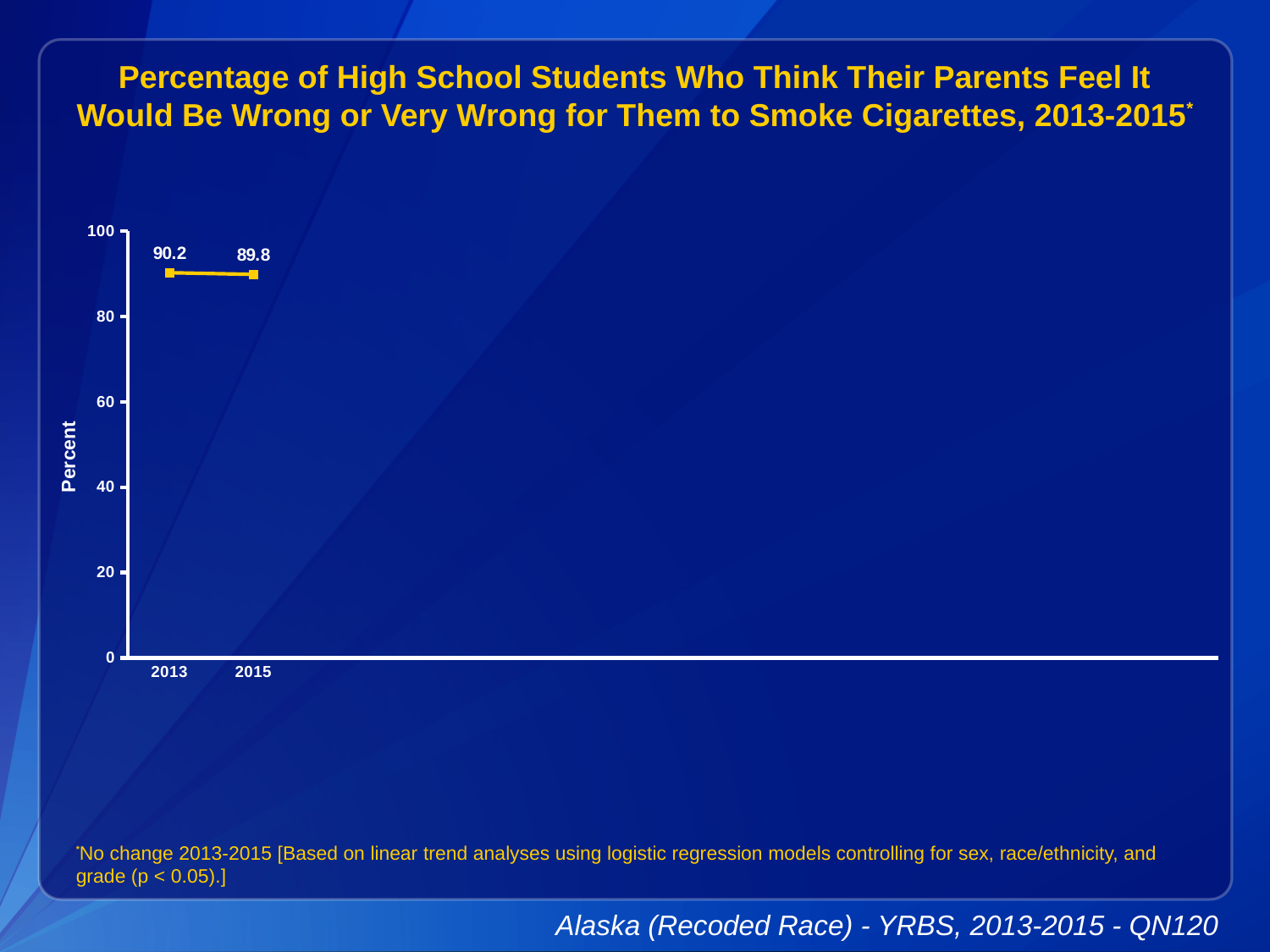
What is the value for 2015? 89.8 What is the label on the y axis? Percent Do the values rise or fall from 2013 to 2015? fall What kind of chart is shown on the slide? line chart Which year has the higher value, 2013 or 2015? 2013 How many data points are plotted on the chart? 2 What is the value for 2013? 90.2 What is the maximum value shown on the y axis? 100 What is the difference between the 2013 and 2015 values? 0.4 Is the value for 2015 greater or less than 80? greater